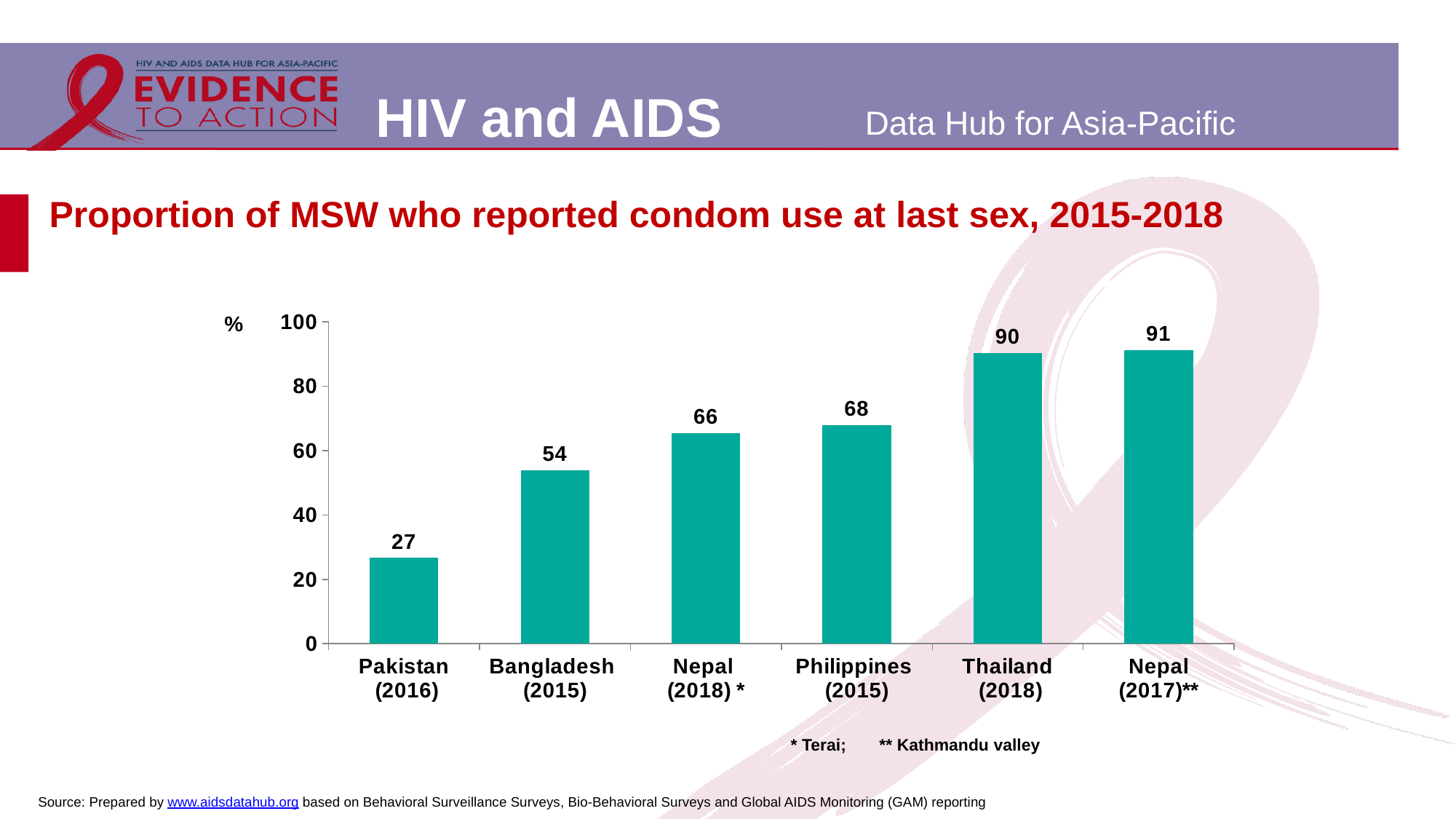
Which category has the lowest value? Pakistan (2016) What is the value for Nepal (2018) *? 66 What is the value for Thailand (2018)? 90 What is the title of the chart? Proportion of MSW who reported condom use at last sex, 2015-2018 What is the difference between the values for Bangladesh (2015) and Pakistan (2016)? 27 Do the values rise or fall from left to right along the x axis? rise What kind of chart is shown on the slide? bar chart Which category has the highest value? Nepal (2017)** Is the value for Thailand (2018) greater or less than 80? greater How many categories are shown on the x axis? 6 What is the value for Pakistan (2016)? 27 Which is larger, the value for Philippines (2015) or the value for Bangladesh (2015)? Philippines (2015)